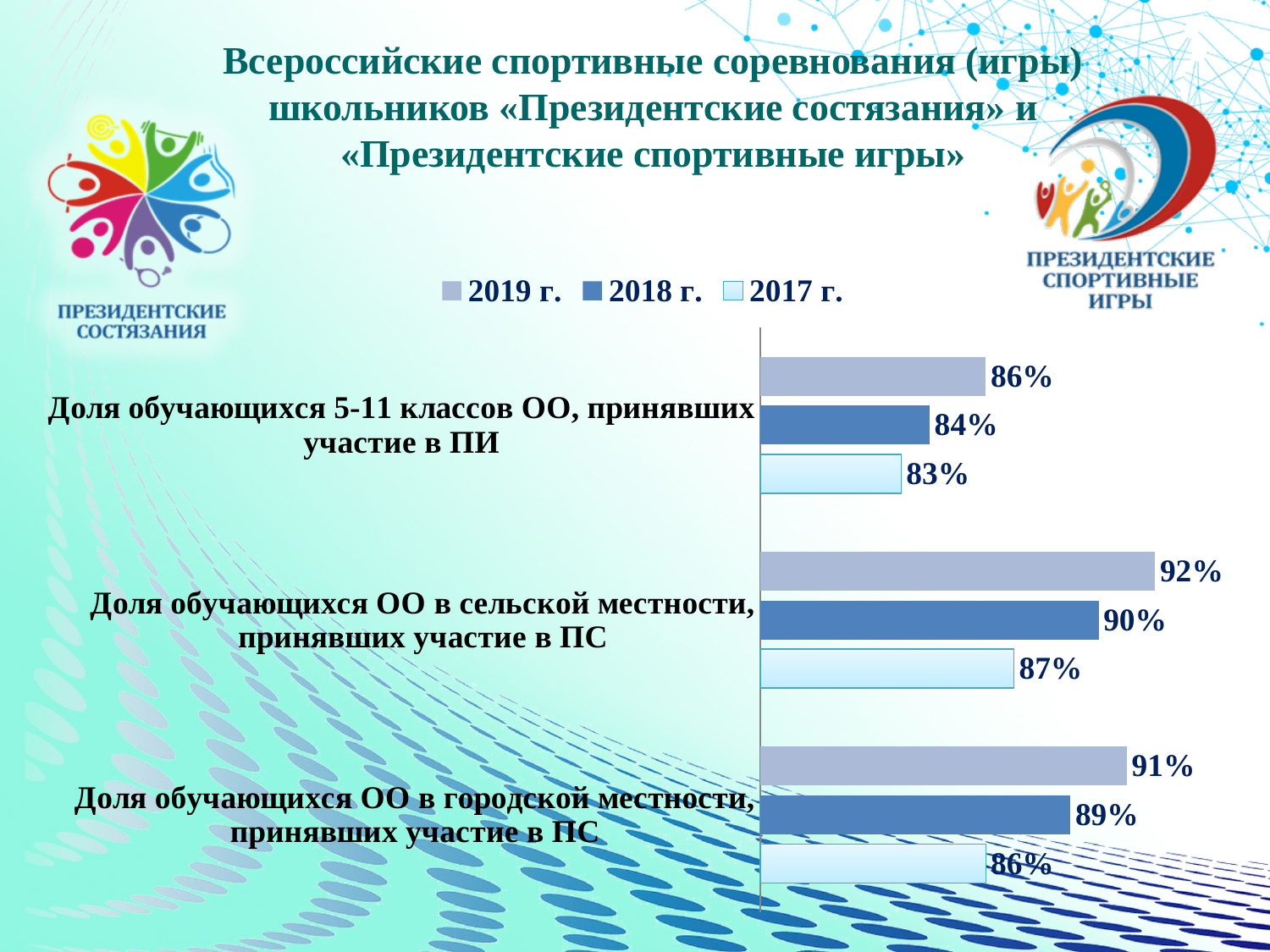
Which category has the lowest 2017 г. value? Доля обучающихся 5-11 классов ОО, принявших участие в ПИ What is the difference between the 2019 г. and 2017 г. values for «Доля обучающихся ОО в сельской местности, принявших участие в ПС»? 5% What is the difference between the 2019 г. and 2018 г. values for «Доля обучающихся ОО в городской местности, принявших участие в ПС»? 2% How many categories are shown on the chart? 3 What is the 2017 г. value for «Доля обучающихся ОО в сельской местности, принявших участие в ПС»? 87% How many series does the legend list? 3 What is the 2019 г. value for «Доля обучающихся 5-11 классов ОО, принявших участие в ПИ»? 86% What is the 2018 г. value for «Доля обучающихся ОО в городской местности, принявших участие в ПС»? 89% Which is larger: the 2018 г. value for «Доля обучающихся ОО в сельской местности, принявших участие в ПС» or the 2018 г. value for «Доля обучающихся 5-11 классов ОО, принявших участие в ПИ»? Доля обучающихся ОО в сельской местности, принявших участие в ПС Which category has the highest 2019 г. value? Доля обучающихся ОО в сельской местности, принявших участие в ПС What kind of chart is shown on the slide? Bar chart Which series is shown in the lightest colour in the legend? 2017 г.